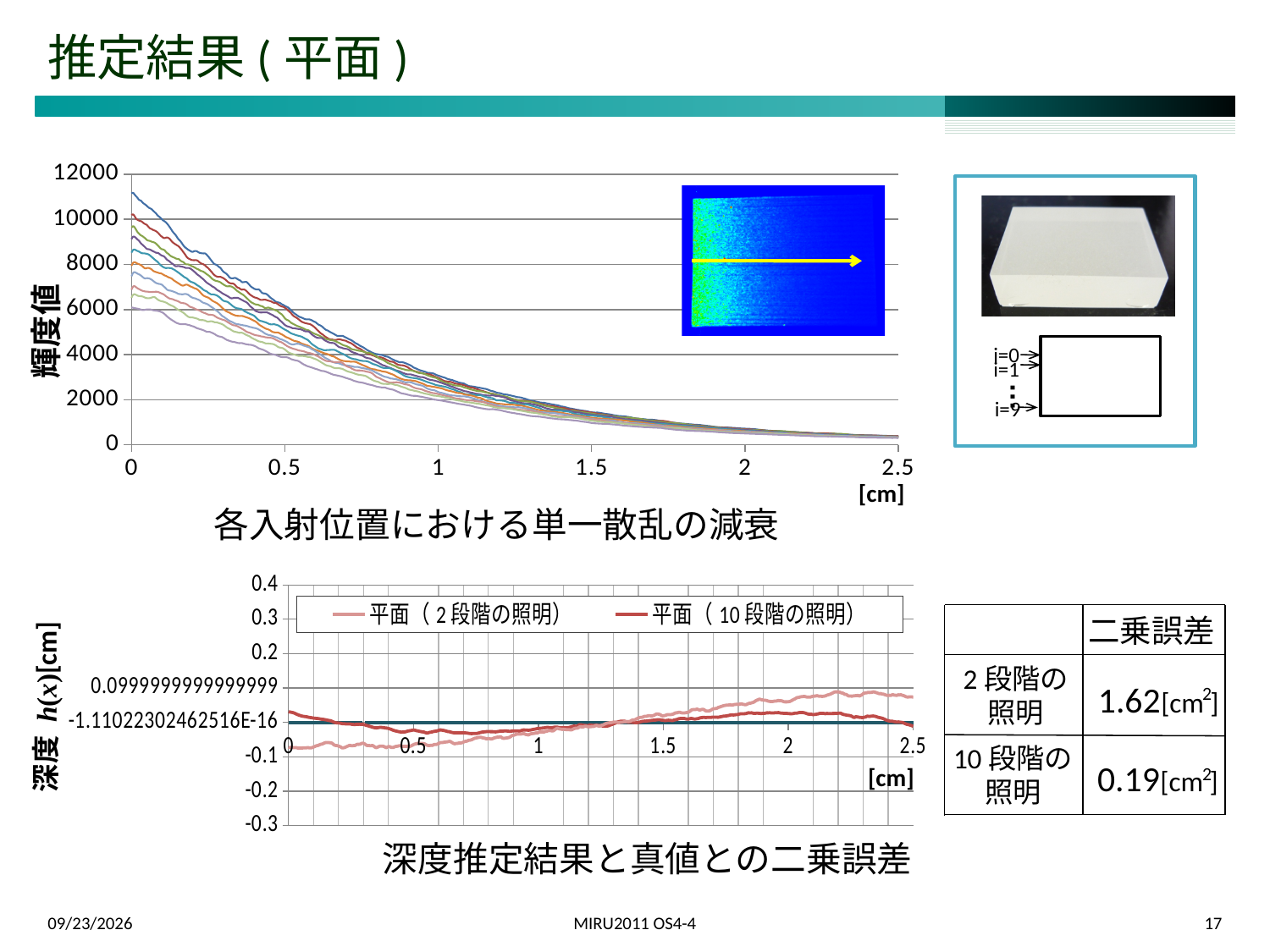
In the bottom chart, what are the two legend entries? 平面(2段階の照明) and 平面(10段階の照明) In the top chart, what is the largest tick value shown on the x axis? 2.5 What kind of chart is the top chart (各入射位置における単一散乱の減衰)? line chart In the top chart, what is the highest tick value shown on the y axis? 12000 In the top chart, do the plotted values rise or fall as x increases from 0 to 2.5 cm? fall In the bottom chart, is the value of the 平面(2段階の照明) series at x = 2.5 greater or less than 0? greater In the top chart, is the value of the highest line at x = 0 greater or less than 10000? greater In the bottom chart, how many series does the legend list? 2 What kind of chart is the bottom chart (深度推定結果と真値との二乗誤差)? line chart What is the y-axis label of the top chart? 輝度値 In the bottom chart, what are the lowest and highest tick values shown on the y axis? -0.3 and 0.4 In the top chart, are the values of all lines at x = 2.5 greater or less than 2000? less